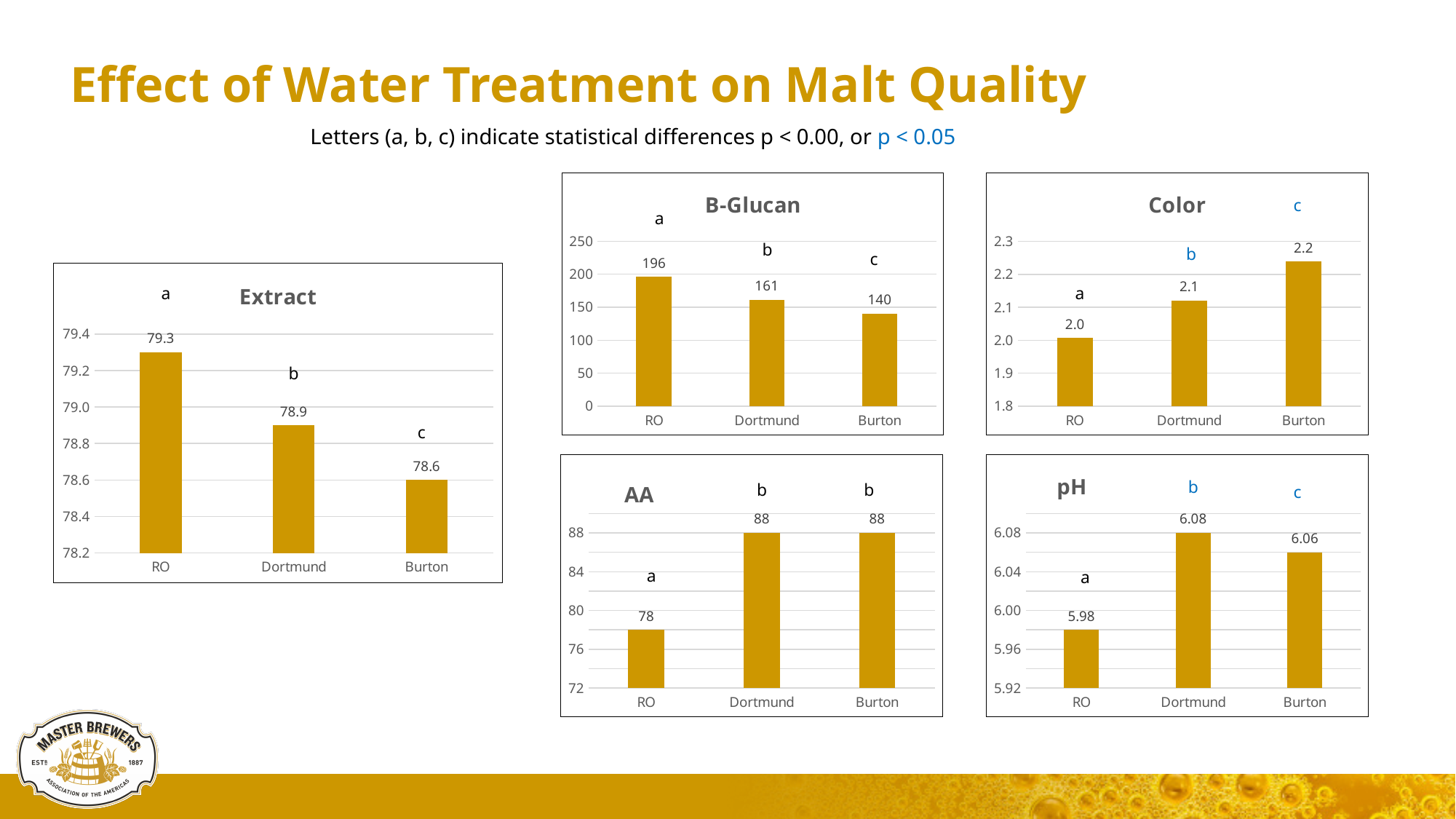
In the B-Glucan chart, what is the value for Dortmund? 161 In the Extract chart, which water treatment has the lowest value? Burton In the AA chart, what is the value for RO? 78 In the Extract chart, what is the value for RO? 79.3 In the pH chart, what is the difference between the Dortmund and RO values? 0.10 In the pH chart, what is the value for Dortmund? 6.08 In the B-Glucan chart, which water treatment has the highest value? RO In the AA chart, which is larger, the value for RO or the value for Dortmund? Dortmund How many charts are shown on the slide? 5 In the Color chart, do the values rise or fall from RO to Burton? rise In the Color chart, what is the value for Burton? 2.2 In the B-Glucan chart, what is the difference between the RO and Burton values? 56